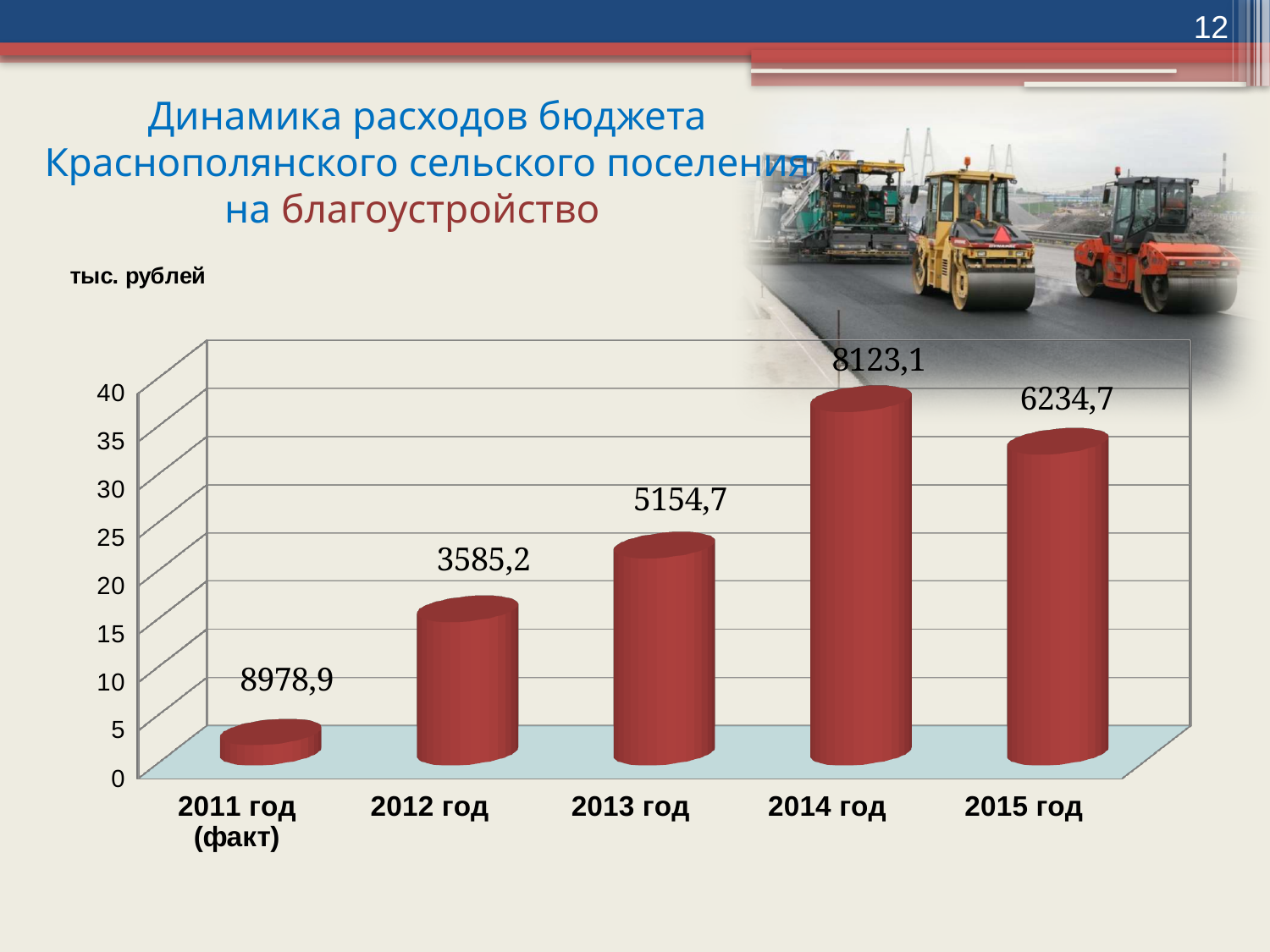
Which is larger, the value for 2012 год or the value for 2013 год? 2013 год What unit is indicated above the chart? тыс. рублей What is the value labelled for 2011 год (факт)? 8978,9 What is the value for 2014 год? 8123,1 What is the difference between the values for 2014 год and 2015 год? 1888,4 What is the difference between the values for 2013 год and 2012 год? 1569,5 What is the value for 2013 год? 5154,7 What kind of chart is shown on the slide? Bar chart What is the value for 2015 год? 6234,7 Which is larger, the value for 2014 год or the value for 2015 год? 2014 год What is the value for 2012 год? 3585,2 How many categories (years) are shown on the x axis? 5